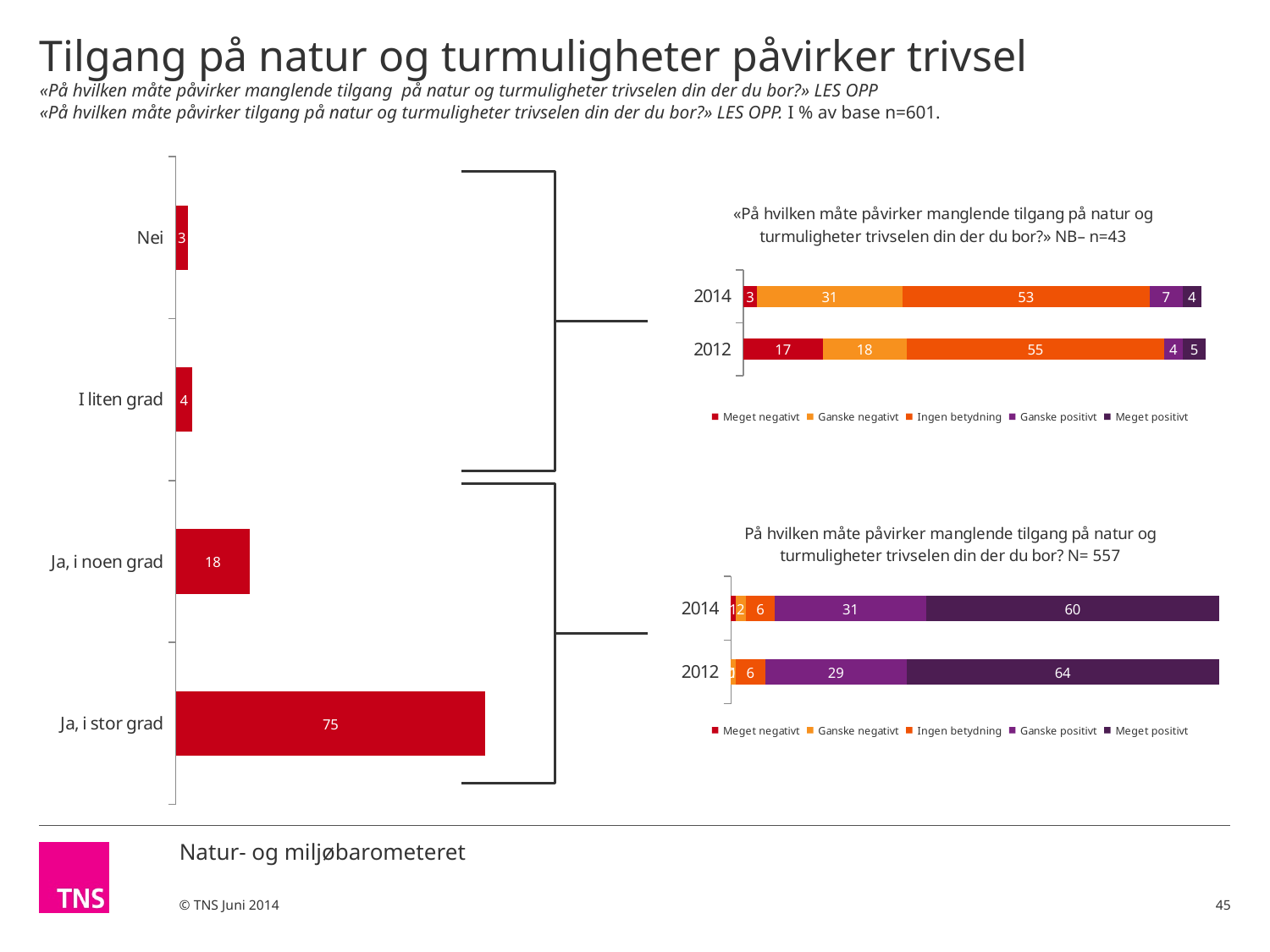
How many categories does the left bar chart show? 4 What kind of chart is the left chart? Bar chart In the bottom-right stacked bar chart (N= 557), what is the value of "Meget positivt" for 2014? 60 In the bottom-right stacked bar chart (N= 557), is "Ganske positivt" larger in 2014 or 2012? 2014 In the left bar chart, what is the difference between "Ja, i stor grad" and "Ja, i noen grad"? 57 How many series does the legend of the top-right stacked bar chart list? 5 In the left bar chart, what is the value for "Ja, i noen grad"? 18 In the top-right stacked bar chart (NB– n=43), what is the value of "Meget negativt" for 2012? 17 In the left bar chart, which category has the highest value? Ja, i stor grad In the left bar chart, which category has the lowest value? Nei In the left bar chart, what is the value for "Ja, i stor grad"? 75 In the top-right stacked bar chart (NB– n=43), what is the value of "Ingen betydning" for 2014? 53